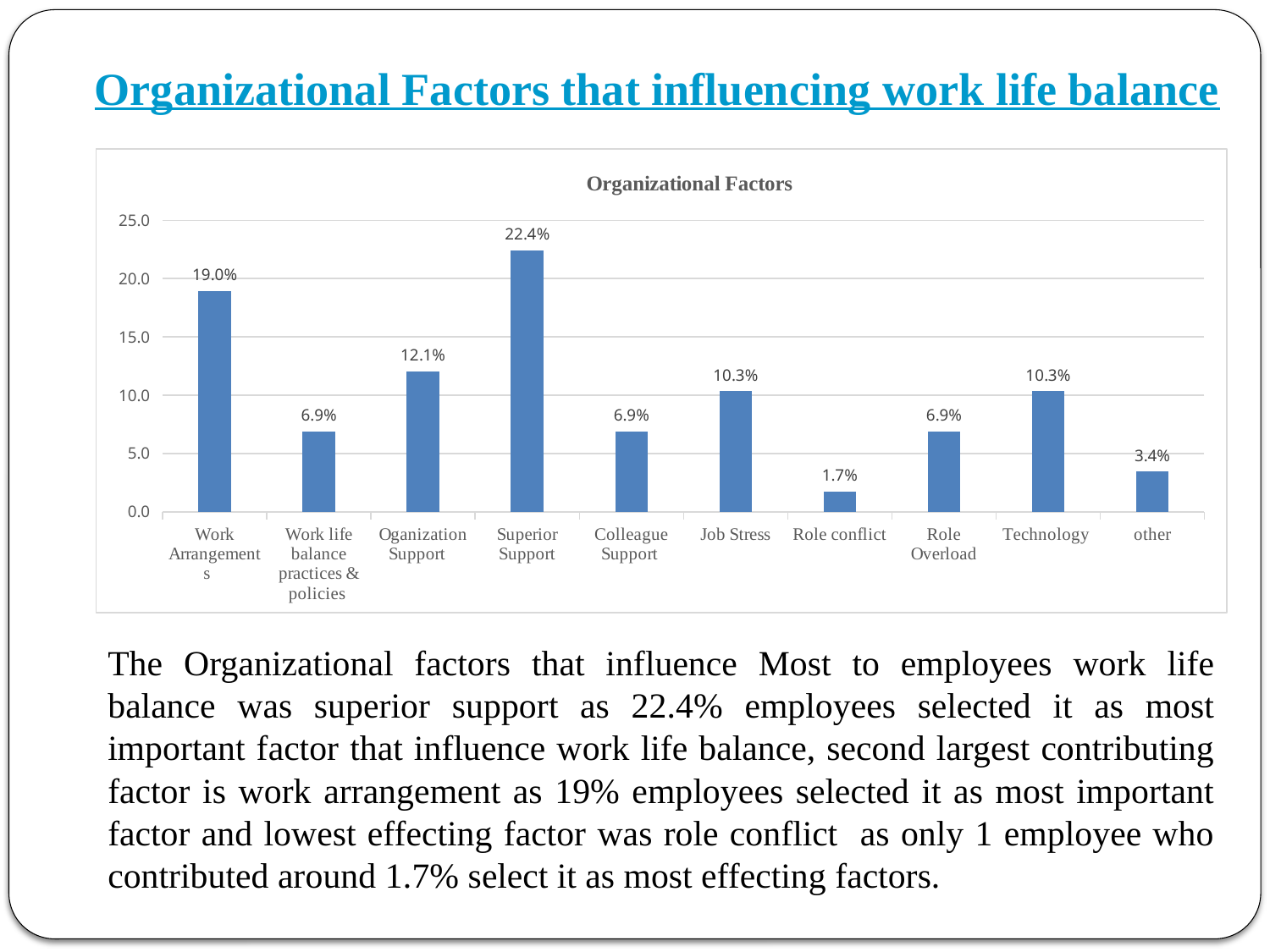
What is the difference between the values for Superior Support and Work Arrangements? 3.4% What is the title of the chart on the slide? Organizational Factors What is the value for Work Arrangements in the Organizational Factors chart? 19.0% What kind of chart is shown on the slide? Bar chart Which category has the lowest value in the Organizational Factors chart? Role conflict Which is larger, the value for Job Stress or the value for Role Overload? Job Stress What is the value for Role conflict in the Organizational Factors chart? 1.7% What is the value for Superior Support in the Organizational Factors chart? 22.4% What is the value for Technology in the Organizational Factors chart? 10.3% What is the difference between the values for Oganization Support and Colleague Support? 5.2% How many categories are shown on the x axis of the Organizational Factors chart? 10 Which category has the highest value in the Organizational Factors chart? Superior Support